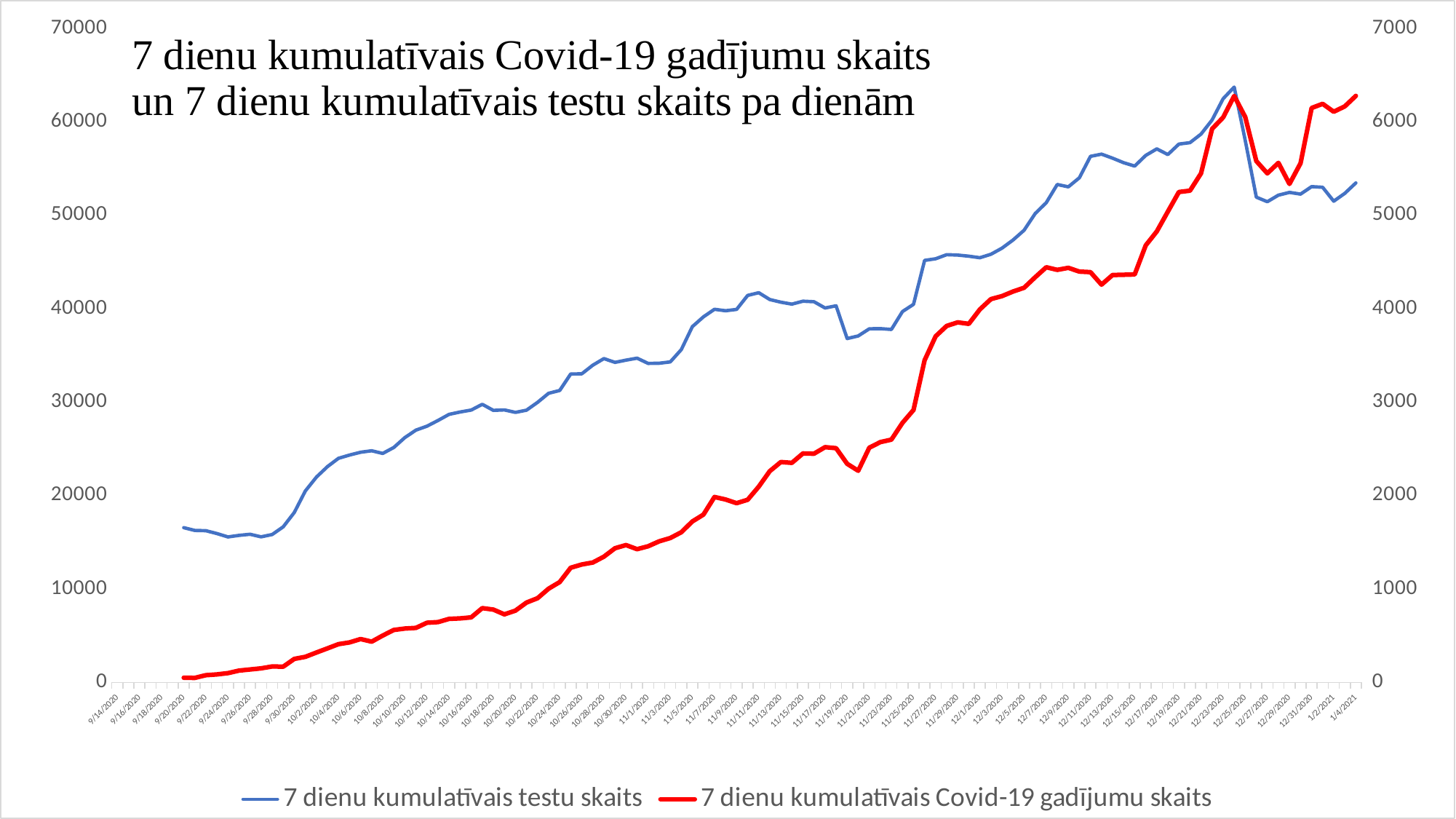
How many series does the legend list? 2 Is the value of the '7 dienu kumulatīvais testu skaits' line on 9/20/2020 greater or less than 20000? less In which month does the '7 dienu kumulatīvais testu skaits' line reach its highest point? December 2020 What kind of chart is shown on the slide? line chart Is the value of the '7 dienu kumulatīvais Covid-19 gadījumu skaits' line on 12/7/2020 greater or less than 4000 on the right axis? greater Which colour is used for the series '7 dienu kumulatīvais Covid-19 gadījumu skaits'? red Is the value of the '7 dienu kumulatīvais Covid-19 gadījumu skaits' line on 11/1/2020 greater or less than 2000 on the right axis? less Overall, does the '7 dienu kumulatīvais Covid-19 gadījumu skaits' line rise or fall from September 2020 to January 2021? rise What is the title of the chart? 7 dienu kumulatīvais Covid-19 gadījumu skaits un 7 dienu kumulatīvais testu skaits pa dienām